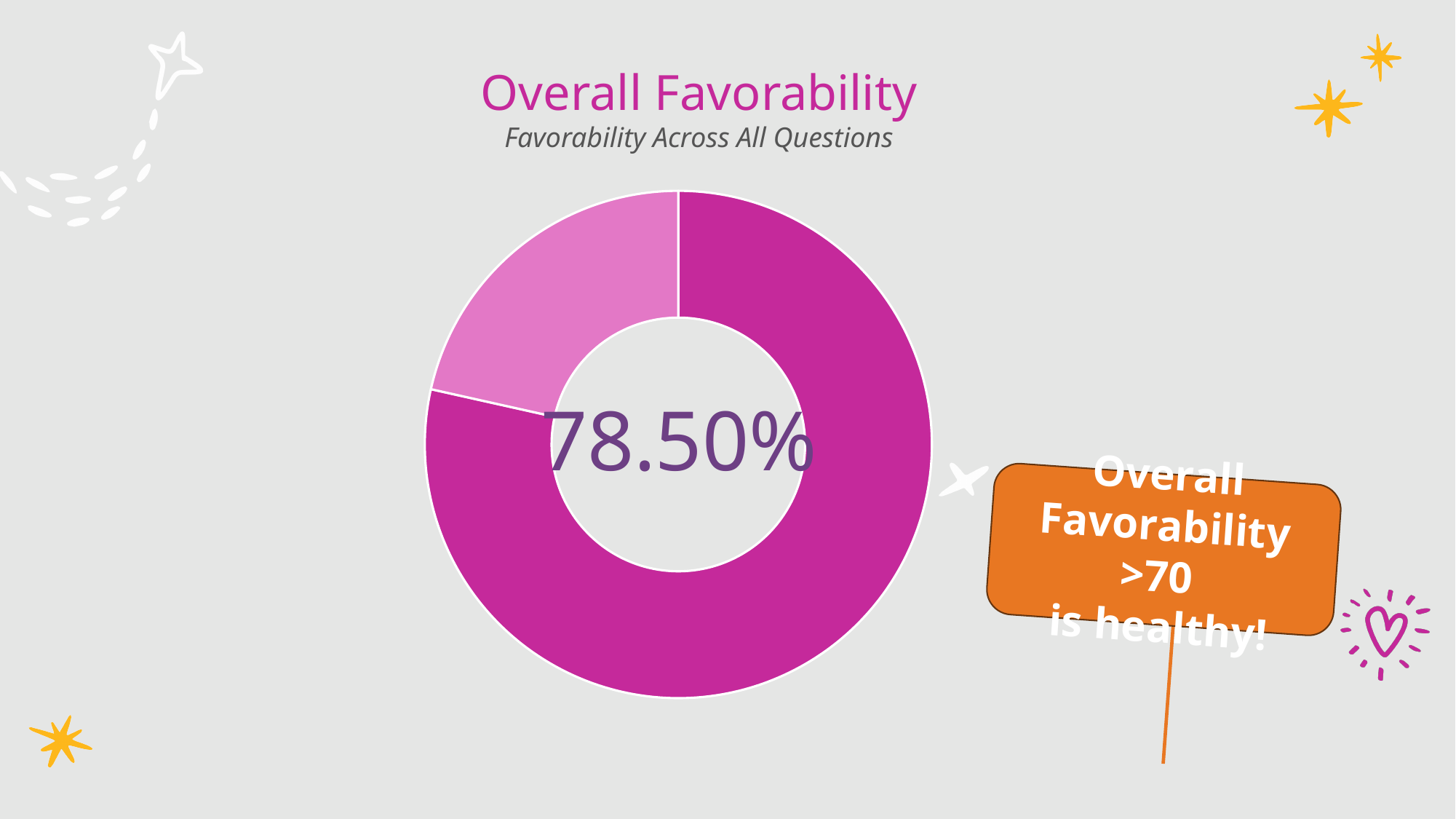
What is the subtitle shown under the chart title? Favorability Across All Questions Which slice of the doughnut chart is the smallest? The light pink slice What overall favorability value is printed in the centre of the doughnut chart? 78.50% What kind of chart is shown on the slide? Doughnut chart Is the overall favorability value shown in the chart greater or less than 70? greater Which slice of the doughnut chart is larger, the dark magenta one or the light pink one? Dark magenta What is the title of the chart? Overall Favorability Is the overall favorability value shown in the chart greater or less than 80? less How many slices does the doughnut chart have? 2